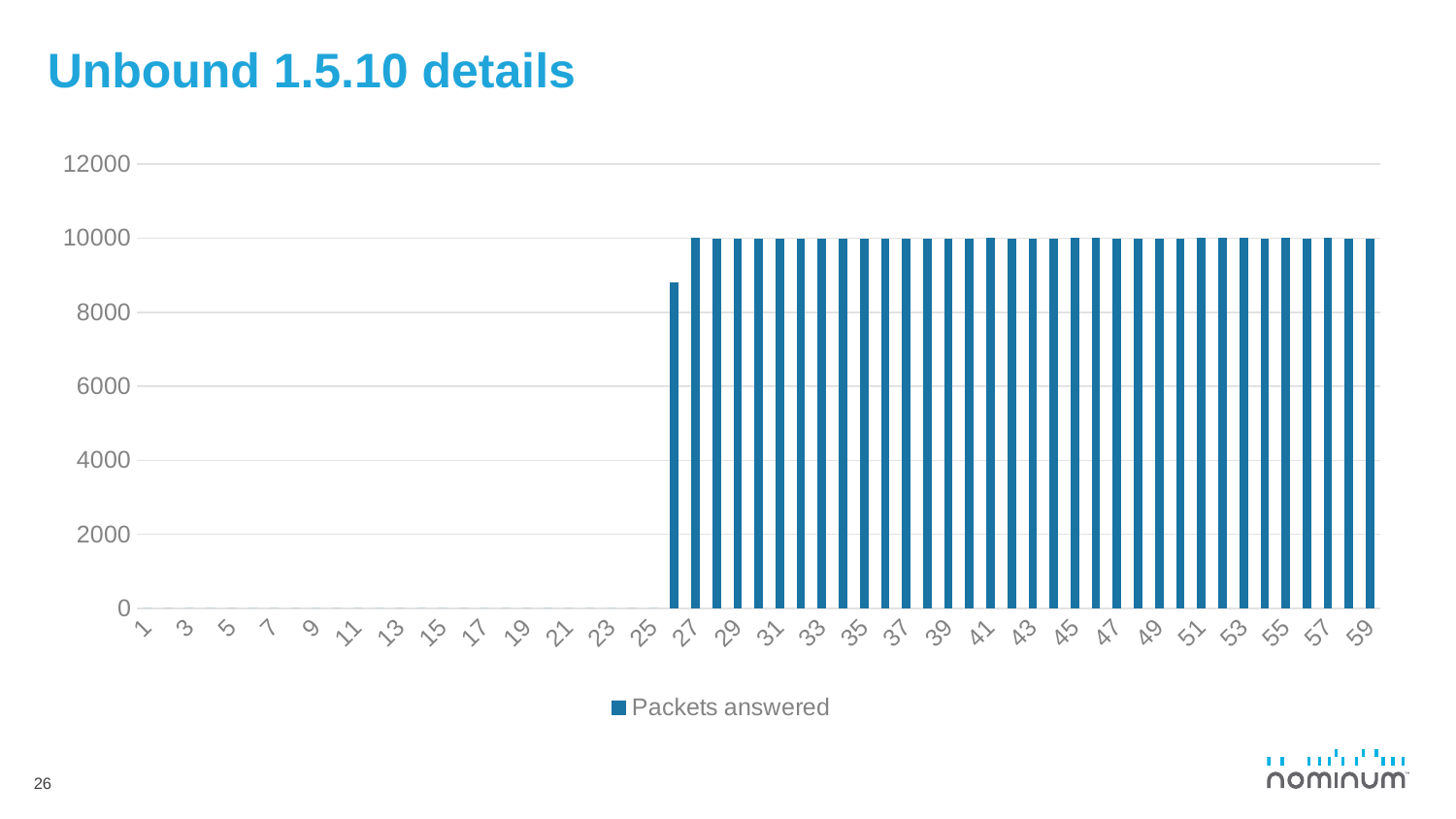
What kind of chart is shown on the slide? bar chart Is the value for category 26 greater or less than 10000? less Which is larger, the value for category 26 or the value for category 27? 27 Is the value for category 26 greater or less than 8000? greater What is the name of the series shown in the legend? Packets answered Do the values generally rise or fall moving from left to right along the x axis? rise What is the value of Packets answered for category 5? 0 Is the value for category 15 greater or less than 2000? less How many series does the legend list? 1 What is the title of the slide containing the chart? Unbound 1.5.10 details